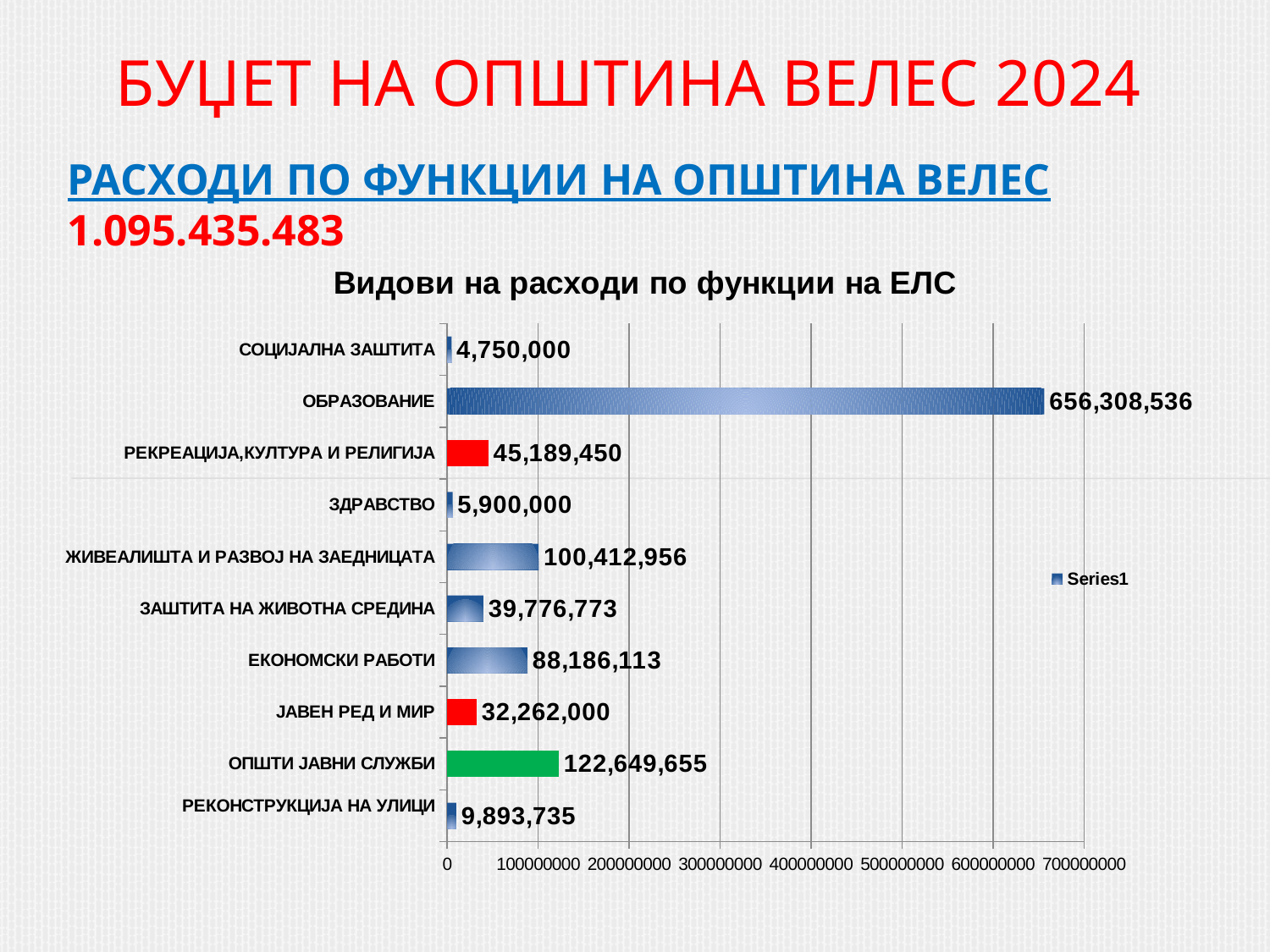
What is the title of the chart? Видови на расходи по функции на ЕЛС What is the difference between the values for ОПШТИ ЈАВНИ СЛУЖБИ and ЖИВЕАЛИШТА И РАЗВОЈ НА ЗАЕДНИЦАТА? 22,236,699 Which category has the highest value? ОБРАЗОВАНИЕ Which is larger, the value for ЕКОНОМСКИ РАБОТИ or the value for РЕКРЕАЦИЈА,КУЛТУРА И РЕЛИГИЈА? ЕКОНОМСКИ РАБОТИ Which category has the lowest value? СОЦИЈАЛНА ЗАШТИТА What is the value for ЈАВЕН РЕД И МИР? 32,262,000 What is the value for ОПШТИ ЈАВНИ СЛУЖБИ? 122,649,655 Is the value for ЕКОНОМСКИ РАБОТИ greater or less than 100000000? less How many categories are shown in the chart? 10 What is the value for ОБРАЗОВАНИЕ in the chart? 656,308,536 What kind of chart is shown on the slide? bar chart What is the value for РЕКОНСТРУКЦИЈА НА УЛИЦИ? 9,893,735